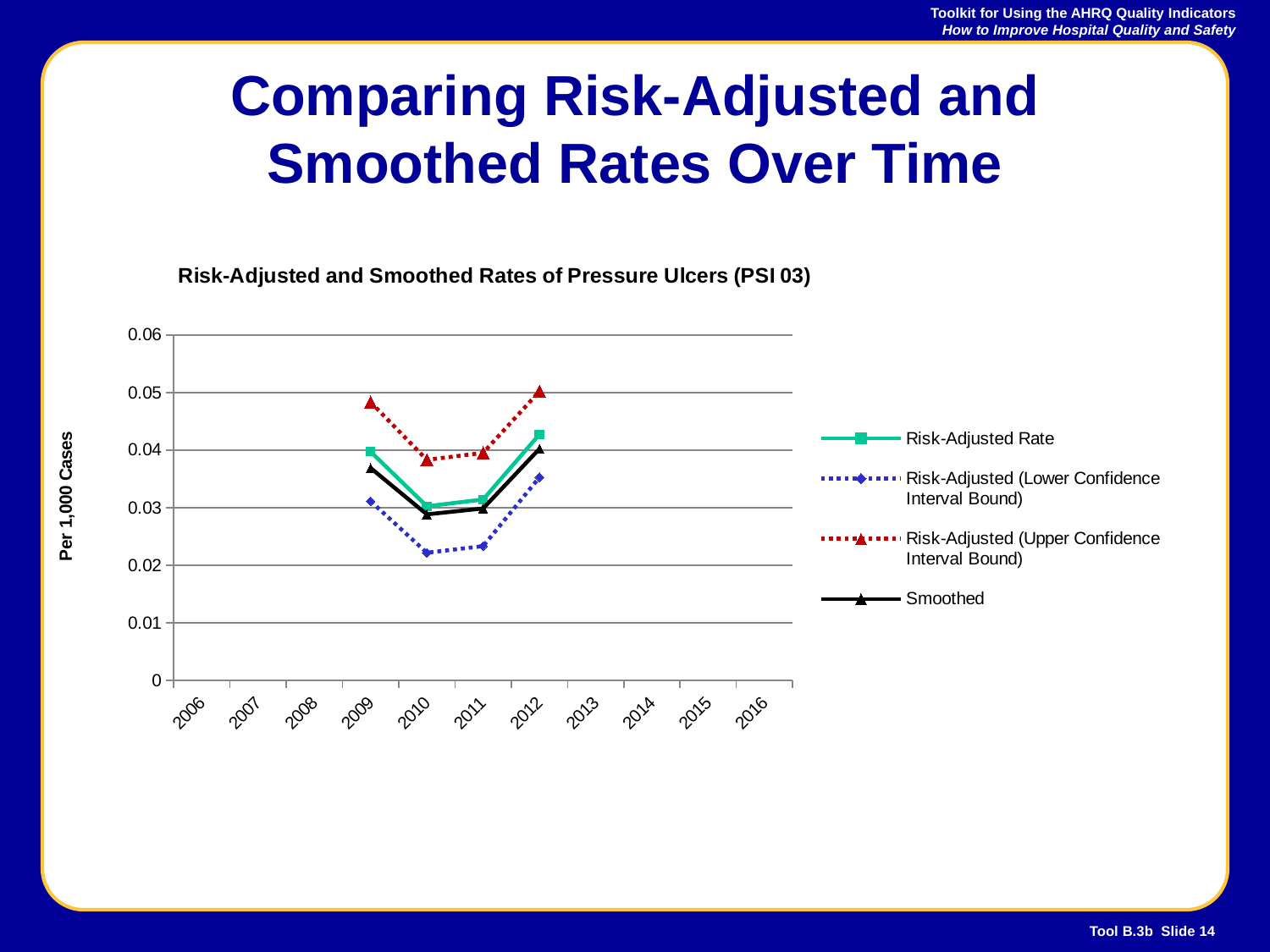
Is the value for Risk-Adjusted (Lower Confidence Interval Bound) in 2010 greater or less than 0.03? less What kind of chart is shown on the slide? line chart What is the title of the chart? Risk-Adjusted and Smoothed Rates of Pressure Ulcers (PSI 03) How many years on the x axis have plotted data points? 4 Is the value for Risk-Adjusted Rate in 2012 greater or less than 0.04? greater How many series does the legend list? 4 Is the value for Risk-Adjusted (Upper Confidence Interval Bound) in 2009 greater or less than 0.04? greater Does the Smoothed rate rise or fall from 2011 to 2012? rise In 2010, which is larger: the Risk-Adjusted (Upper Confidence Interval Bound) or the Risk-Adjusted (Lower Confidence Interval Bound)? Risk-Adjusted (Upper Confidence Interval Bound) Does the Risk-Adjusted Rate rise or fall from 2009 to 2010? fall What is the label on the y axis of the chart? Per 1,000 Cases